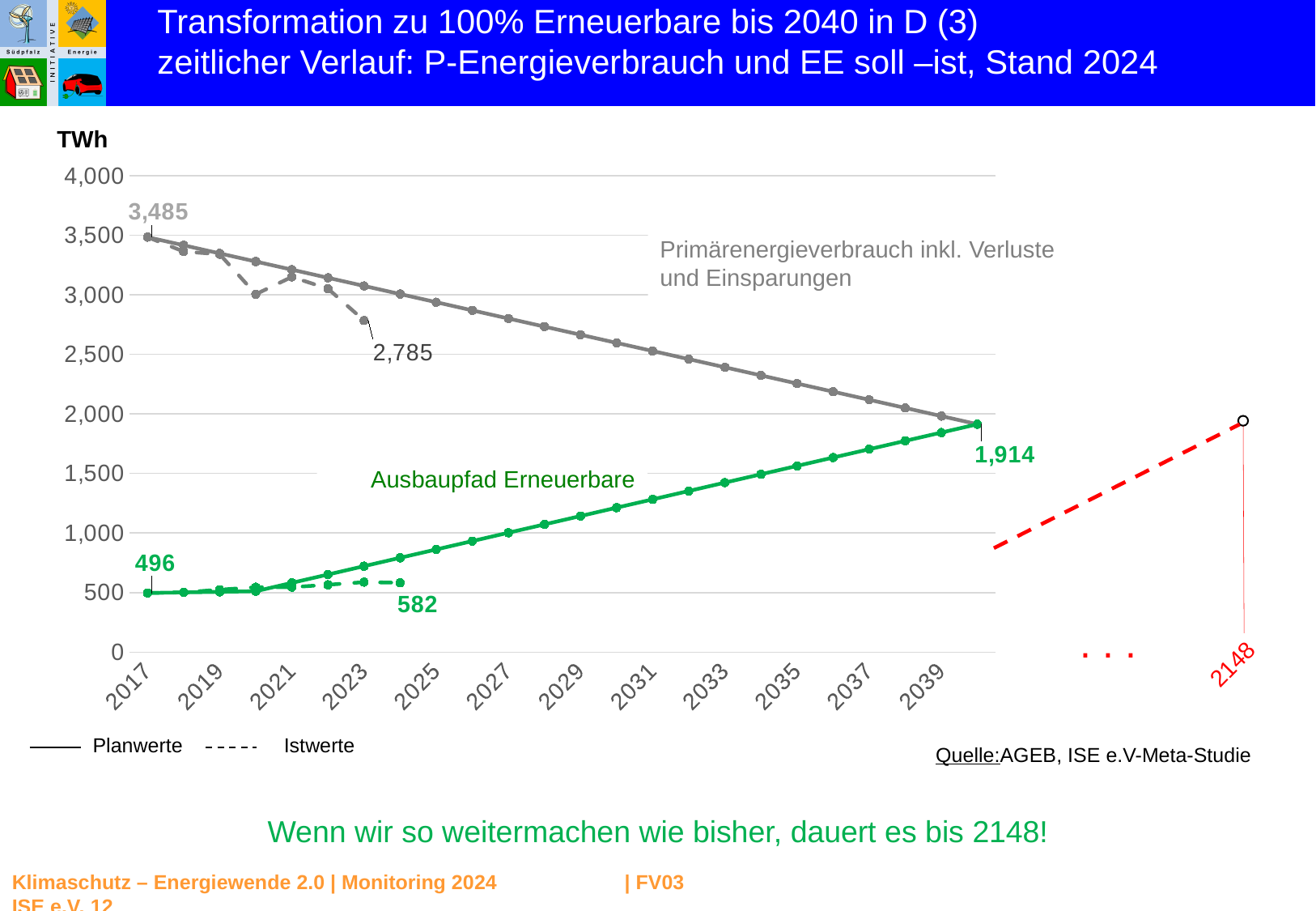
What is the value of Primärenergieverbrauch in 2017? 3,485 What unit is shown on the y axis of the chart? TWh At what value do the Primärenergieverbrauch and Ausbaupfad Erneuerbare lines meet in 2040? 1,914 Which is larger in 2017: Primärenergieverbrauch or Ausbaupfad Erneuerbare? Primärenergieverbrauch What is the value of the Ausbaupfad Erneuerbare in 2017? 496 What kind of chart is shown on the slide? line chart What is the difference between the Erneuerbare Istwert 582 and the 2017 value 496? 86 Does the Primärenergieverbrauch Planwerte line rise or fall from 2017 to 2040? fall What is the Istwert for Erneuerbare labelled near 2023? 582 What is the Istwert for Primärenergieverbrauch labelled near 2023? 2,785 What is the difference between the Primärenergieverbrauch value in 2017 (3,485) and the value where the lines meet in 2040 (1,914)? 1,571 Is the value of the Ausbaupfad Erneuerbare in 2029 greater or less than 1,500? less